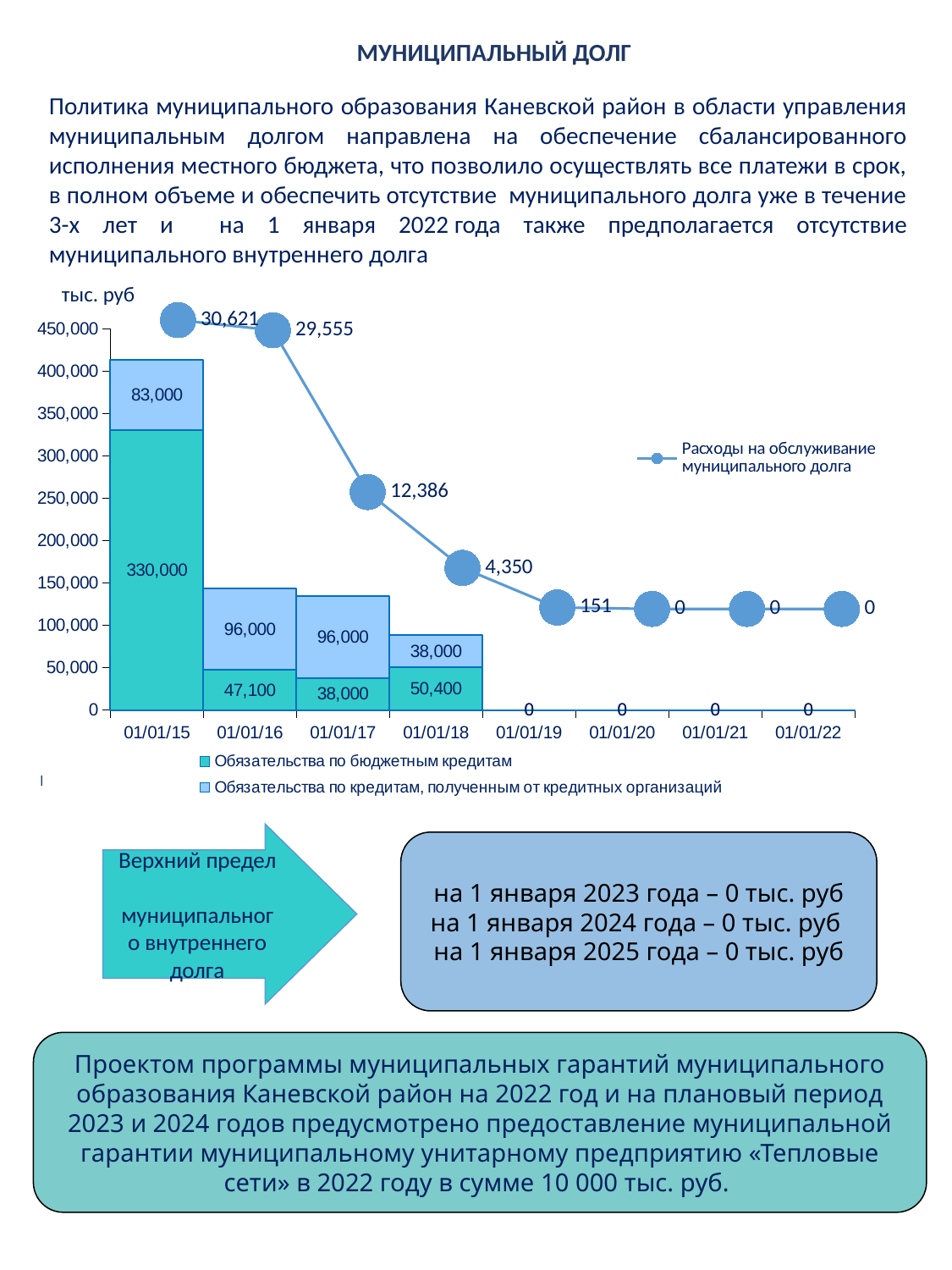
At which date is 'Расходы на обслуживание муниципального долга' highest? 01/01/15 How many series does the chart show? 3 How many dates are shown on the x axis of the chart? 8 Does 'Расходы на обслуживание муниципального долга' rise or fall from 01/01/15 to 01/01/20? fall What is the value of 'Расходы на обслуживание муниципального долга' for 01/01/19? 151 What is the difference between 'Расходы на обслуживание муниципального долга' at 01/01/15 and at 01/01/16? 1,066 What unit is shown above the vertical axis of the chart? тыс. руб What is the total of the stacked bar for 01/01/18? 88,400 What is the value of 'Расходы на обслуживание муниципального долга' for 01/01/17? 12,386 What is the value of 'Обязательства по кредитам, полученным от кредитных организаций' for 01/01/16? 96,000 What is the value of 'Обязательства по бюджетным кредитам' for 01/01/15? 330,000 Which is larger: 'Обязательства по бюджетным кредитам' at 01/01/18 or at 01/01/17? 01/01/18